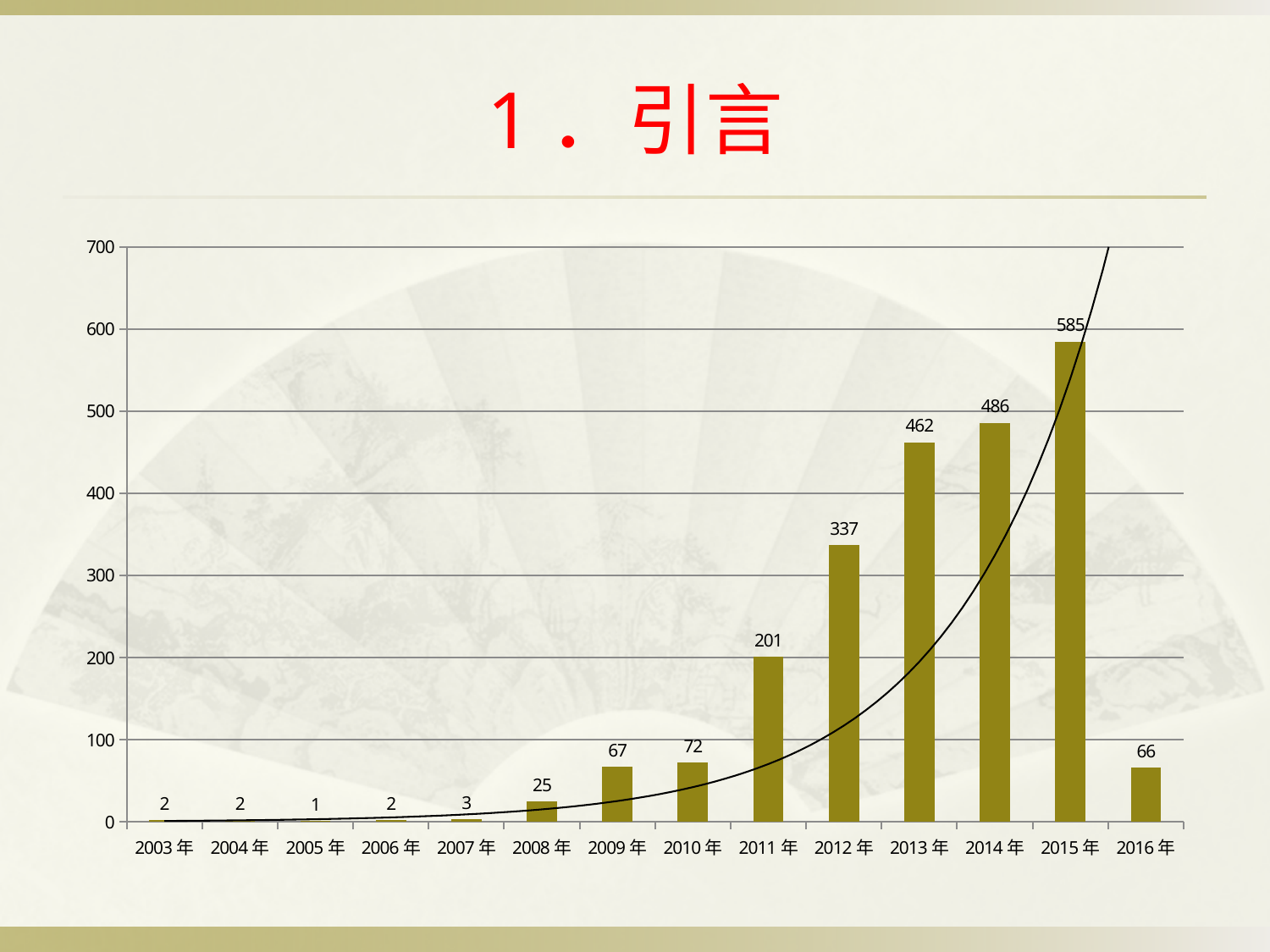
What is the value for 2015年? 585 What is the difference between the values for 2015年 and 2014年? 99 What is the value for 2011年? 201 What is the value for 2016年? 66 Which year has the highest value? 2015年 Which year has the lowest value? 2005年 What is the difference between the values for 2012年 and 2011年? 136 Do the values rise or fall from 2008年 to 2015年? rise Is the value for 2013年 greater or less than 400? greater Which is larger, the value for 2010年 or the value for 2016年? 2010年 How many years are shown on the x axis? 14 What kind of chart is this? bar chart